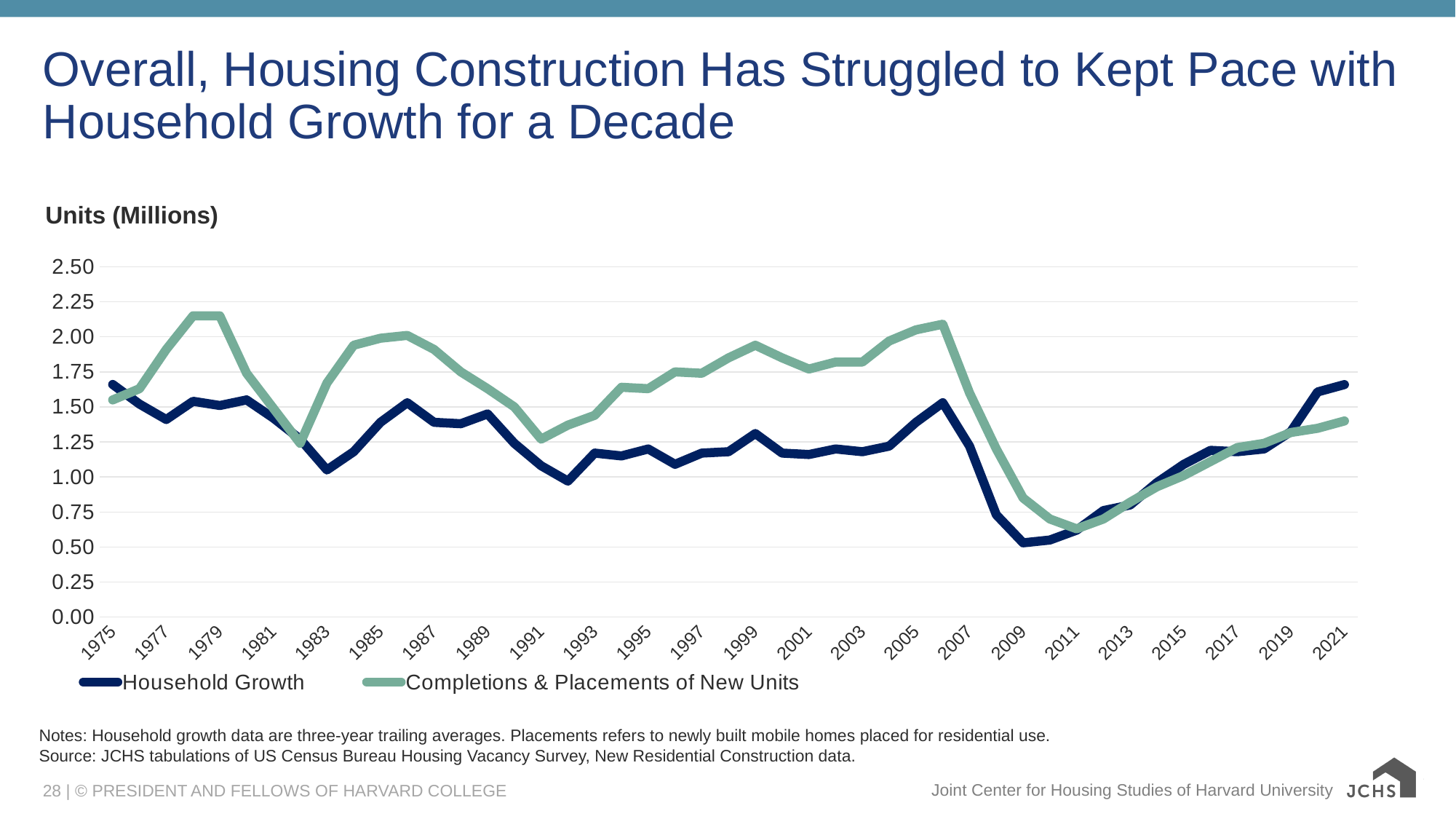
Is the value for Completions & Placements of New Units in 1979 greater or less than 2.00? greater How many series does the legend list? 2 Is the value for Household Growth in 2021 greater or less than 1.50? greater Does the Household Growth line rise or fall between 2009 and 2021? Rise Is the value for Completions & Placements of New Units in 2011 greater or less than 0.75? less What are the two series named in the legend? Household Growth; Completions & Placements of New Units In 2021, which series has the higher value, Household Growth or Completions & Placements of New Units? Household Growth Which series reaches the highest value anywhere on the chart? Completions & Placements of New Units What is the label on the vertical axis of the chart? Units (Millions) What kind of chart is shown on the slide? Line chart In 1979, which series has the higher value, Household Growth or Completions & Placements of New Units? Completions & Placements of New Units